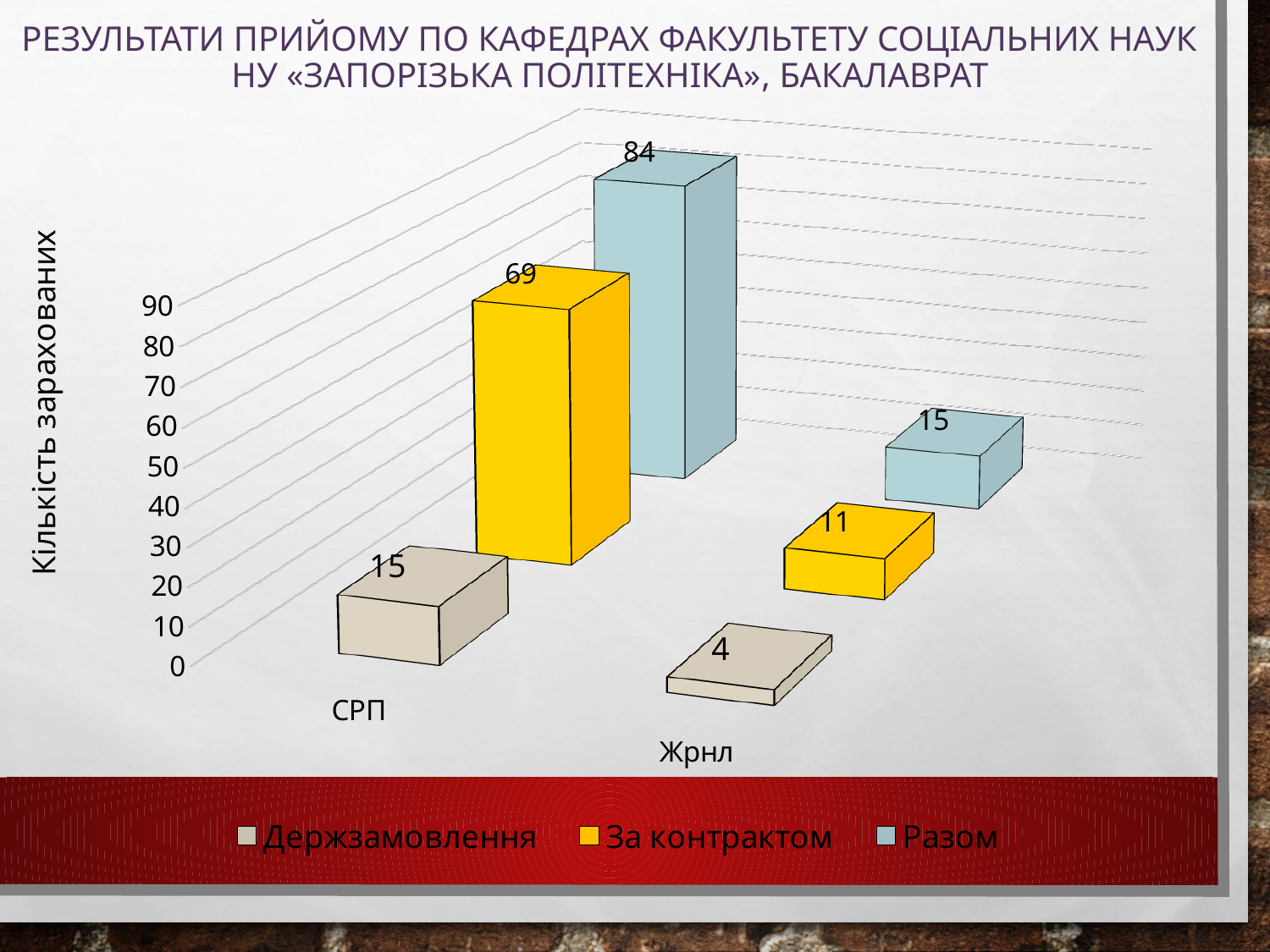
What is the value for Разом in the Жрнл category? 15 How many categories are shown on the x axis? 2 Which is larger: Разом for СРП or Разом for Жрнл? Разом for СРП What kind of chart is shown on the slide? Bar chart What is the value for Держзамовлення in the СРП category? 15 What is the difference between the За контрактом values for СРП and Жрнл? 58 What is the value for За контрактом in the СРП category? 69 How many series does the legend list? 3 What is the value for Держзамовлення in the Жрнл category? 4 What is the label of the vertical axis? Кількість зарахованих Which category has the highest value for Разом? СРП Which category has the lowest value for За контрактом? Жрнл